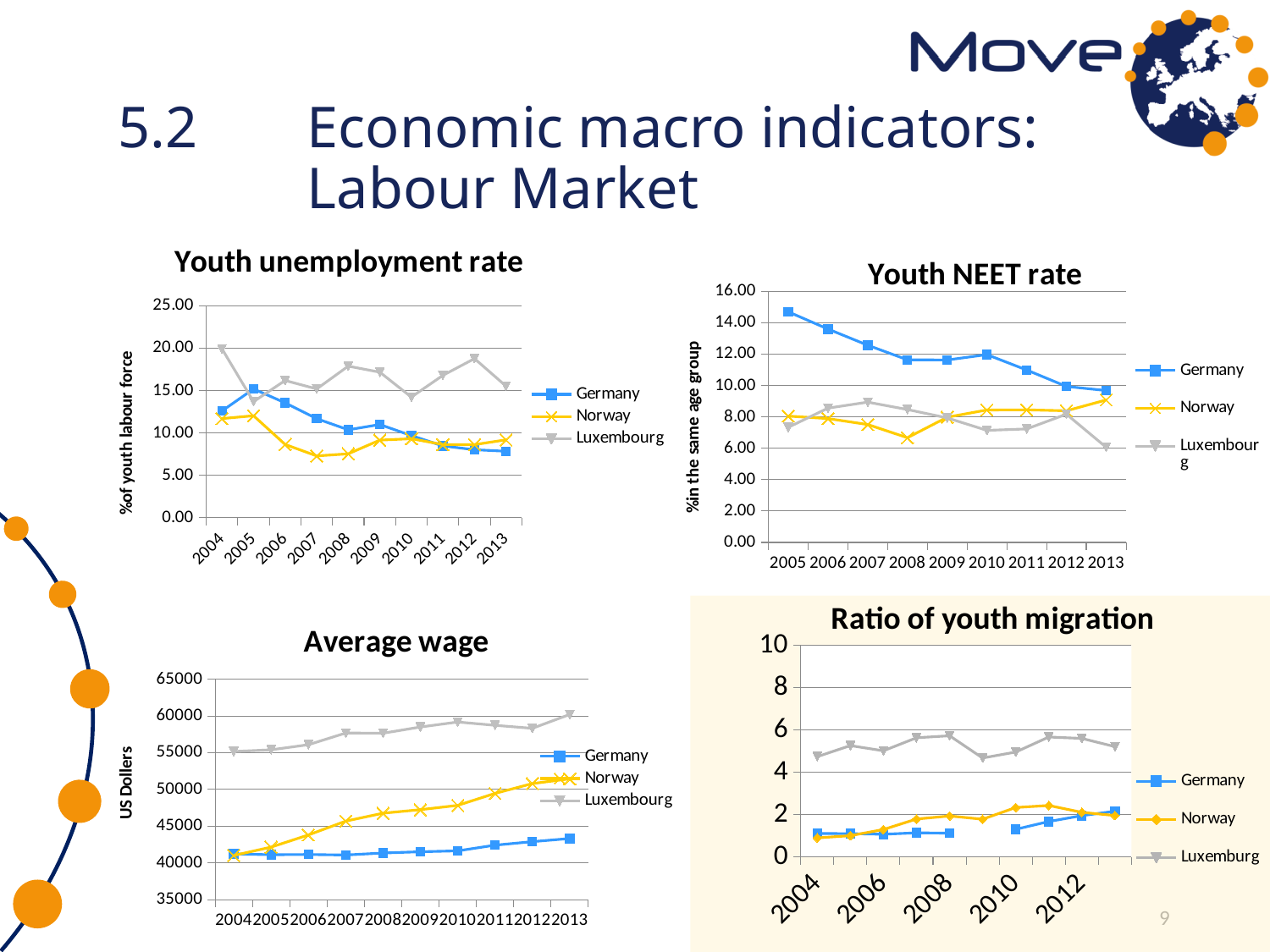
In the "Youth NEET rate" chart, is the value for Luxembourg in 2013 greater or less than 8.00? less In the "Youth unemployment rate" chart, how many years are shown on the x axis? 10 In the "Average wage" chart, which country has the highest average wage in 2013? Luxembourg In the "Youth unemployment rate" chart, how many series does the legend list? 3 In the "Youth NEET rate" chart, which country has the highest value in 2005? Germany In the "Youth unemployment rate" chart, is the value for Germany in 2013 greater or less than 10.00? less In the "Average wage" chart, what is the y-axis label? US Dollars What type of chart is the "Youth unemployment rate" chart? line chart In the "Youth NEET rate" chart, does the Germany series rise or fall from 2005 to 2013? fall In the "Average wage" chart, is the value for Germany in 2013 greater or less than 45000? less In the "Youth unemployment rate" chart, which country has the highest value in 2004? Luxembourg